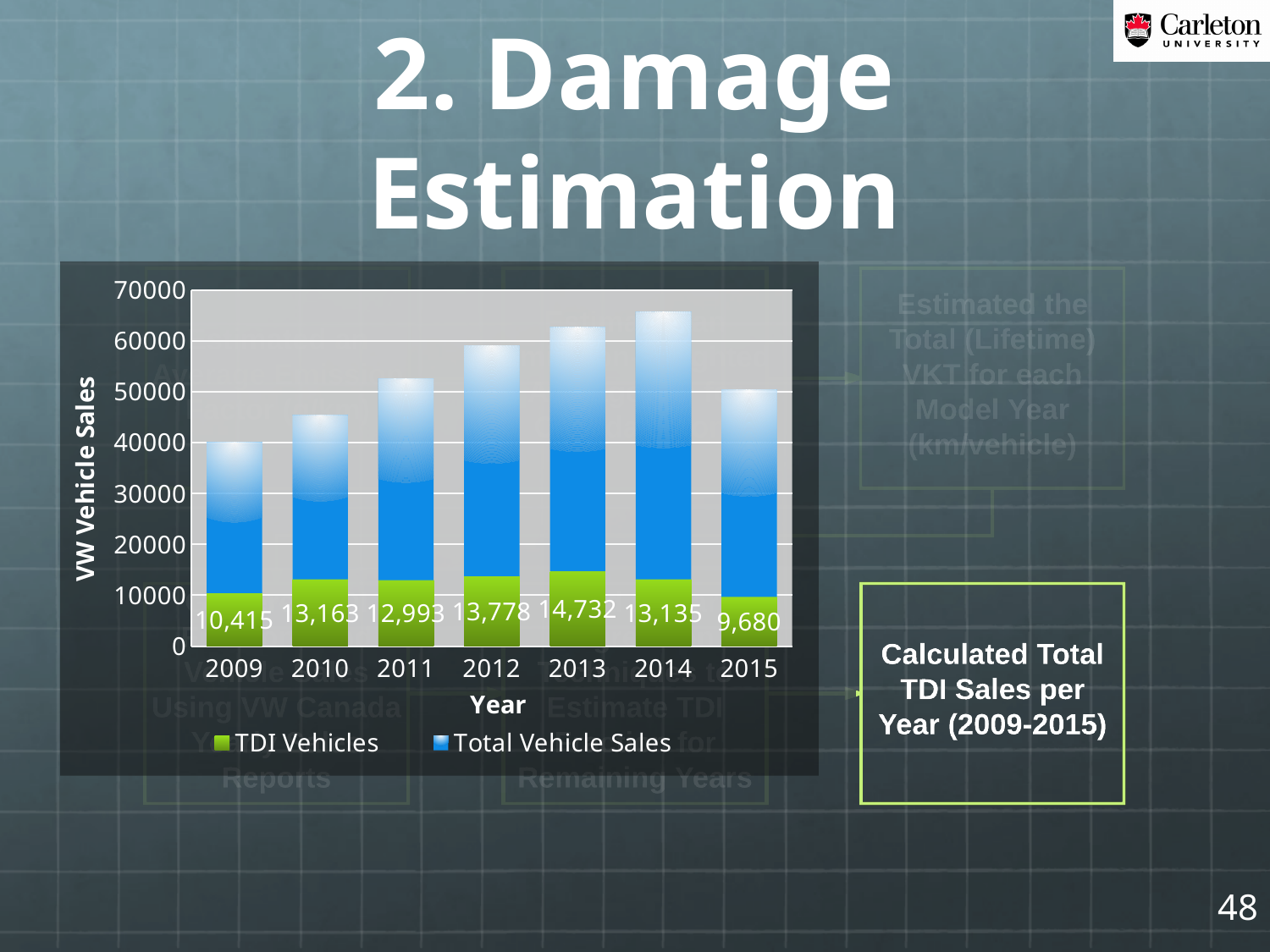
What is the difference between TDI Vehicles in 2013 and in 2015? 5,052 How many series does the legend list? 2 What kind of chart is shown on the slide? Stacked bar chart Which year has the highest number of TDI Vehicles? 2013 Is the total height of the stacked bar for 2014 greater or less than 60000? greater How many years are shown on the x axis? 7 What is the value for TDI Vehicles in 2013? 14,732 What is the value for TDI Vehicles in 2009? 10,415 Which year has the lowest number of TDI Vehicles? 2015 Is the total height of the stacked bar for 2009 greater or less than 50000? less What is the value for TDI Vehicles in 2015? 9,680 Which year has more TDI Vehicles, 2010 or 2011? 2010